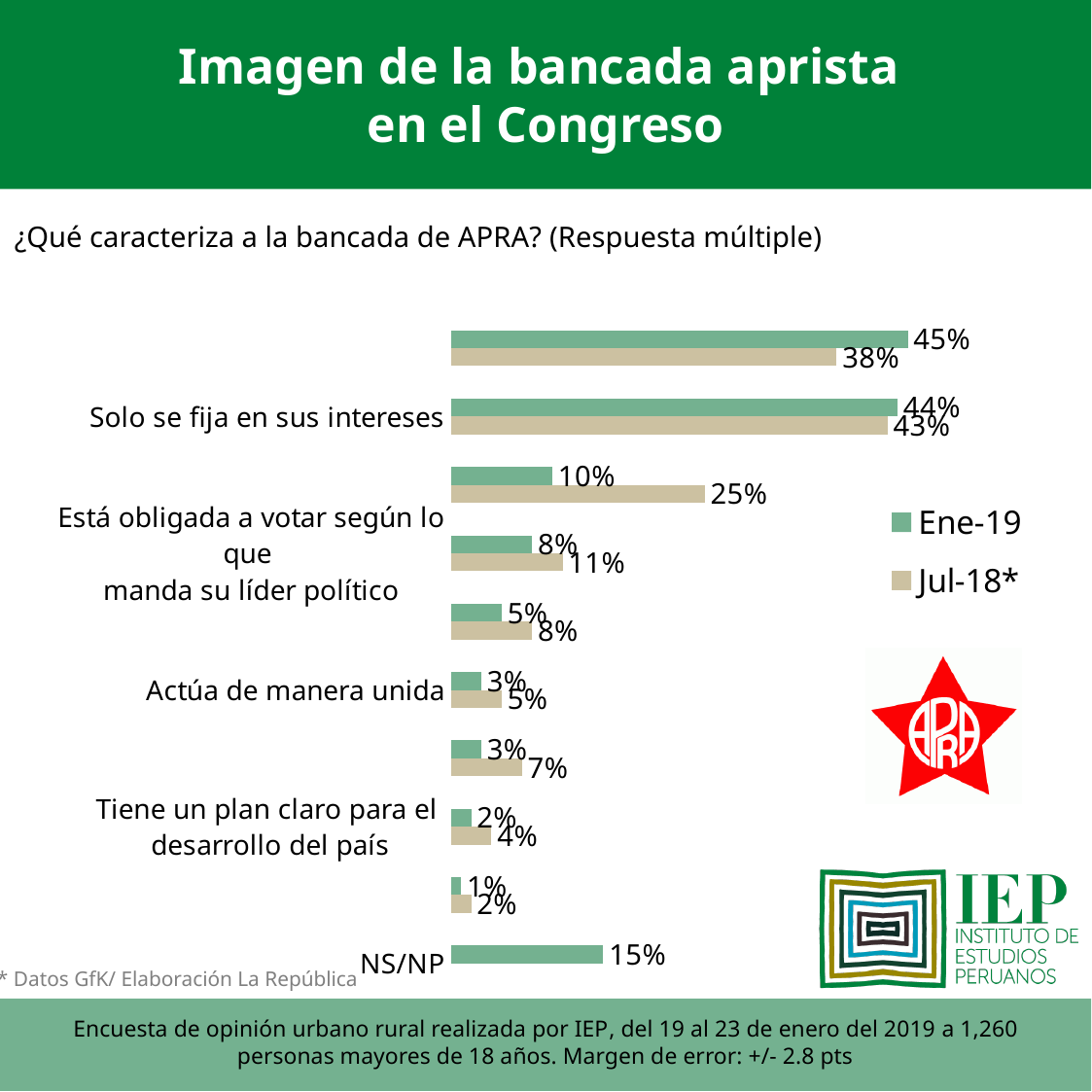
What is the highest Ene-19 value shown in the chart? 45% What is the Ene-19 value for 'Actúa de manera unida'? 3% What is the Ene-19 value for 'NS/NP'? 15% For 'Está obligada a votar según lo que manda su líder político', which series has the larger value, Ene-19 or Jul-18*? Jul-18* What is the Jul-18* value for 'Tiene un plan claro para el desarrollo del país'? 4% What is the Jul-18* value for 'Solo se fija en sus intereses'? 43% What is the Ene-19 value for 'Solo se fija en sus intereses'? 44% What is the Jul-18* value for 'Está obligada a votar según lo que manda su líder político'? 11% What are the two series named in the legend? Ene-19 and Jul-18* What is the difference between the Ene-19 and Jul-18* values for 'Solo se fija en sus intereses'? 1 percentage point How many series does the legend list? 2 What kind of chart is shown on the slide? bar chart